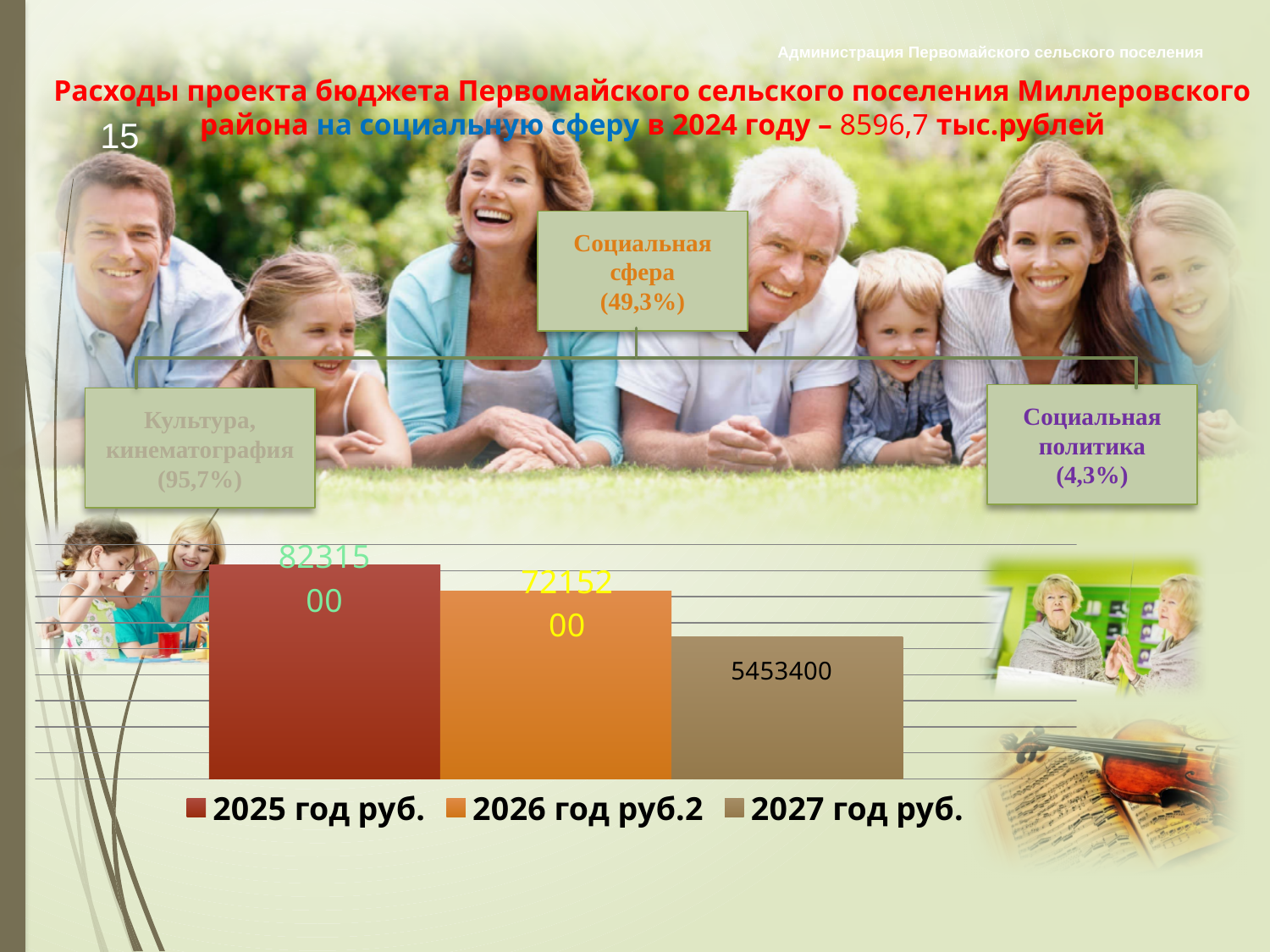
What is the difference between the 2026 год руб.2 value and the 2027 год руб. value? 1761800 Which series has the lowest value in the chart? 2027 год руб. What value is shown for the 2025 год руб. bar? 8231500 What kind of chart is shown on the slide? bar chart Do the values rise or fall from the 2025 bar to the 2027 bar? fall What is the difference between the 2025 год руб. value and the 2026 год руб.2 value? 1016300 What value is shown for the 2027 год руб. bar? 5453400 How many series does the legend list? 3 Which is larger, the value for 2025 год руб. or the value for 2027 год руб.? 2025 год руб. Which series has the highest value in the chart? 2025 год руб. How many bars are plotted in the chart? 3 What value is shown for the 2026 год руб.2 bar? 7215200